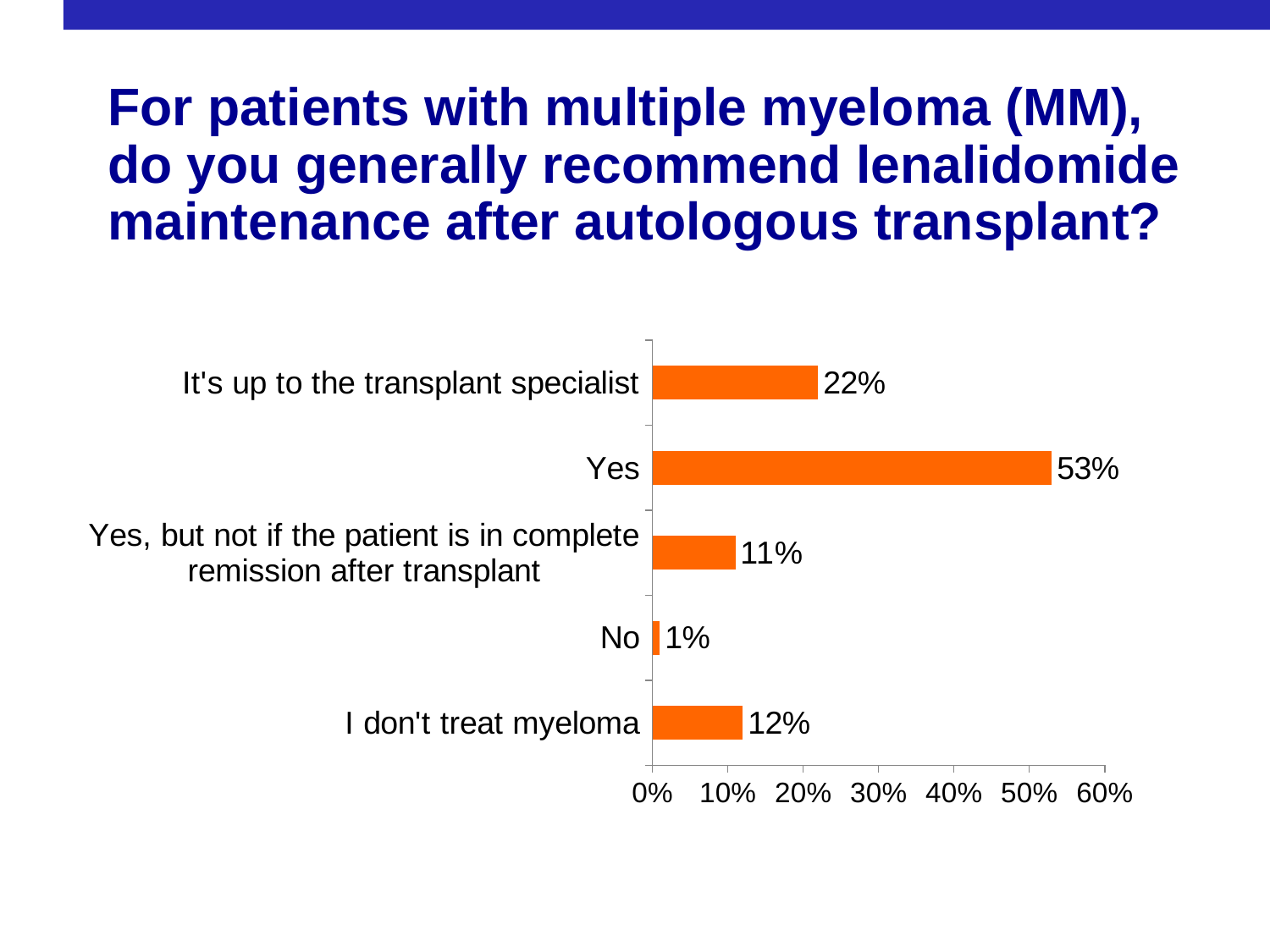
Which response has a larger percentage: "I don't treat myeloma" or "Yes, but not if the patient is in complete remission after transplant"? I don't treat myeloma What type of chart is shown on the slide? Bar chart Is the value for "Yes" greater or less than 50%? greater What is the difference in percentage points between "Yes" and "It's up to the transplant specialist"? 31% What percentage of respondents answered "I don't treat myeloma"? 12% How many response categories are shown in the chart? 5 Which response received the highest percentage? Yes What percentage of respondents answered "Yes"? 53% Which response received the lowest percentage? No What percentage of respondents answered "It's up to the transplant specialist"? 22% What percentage of respondents answered "Yes, but not if the patient is in complete remission after transplant"? 11% What is the maximum value shown on the horizontal axis? 60%